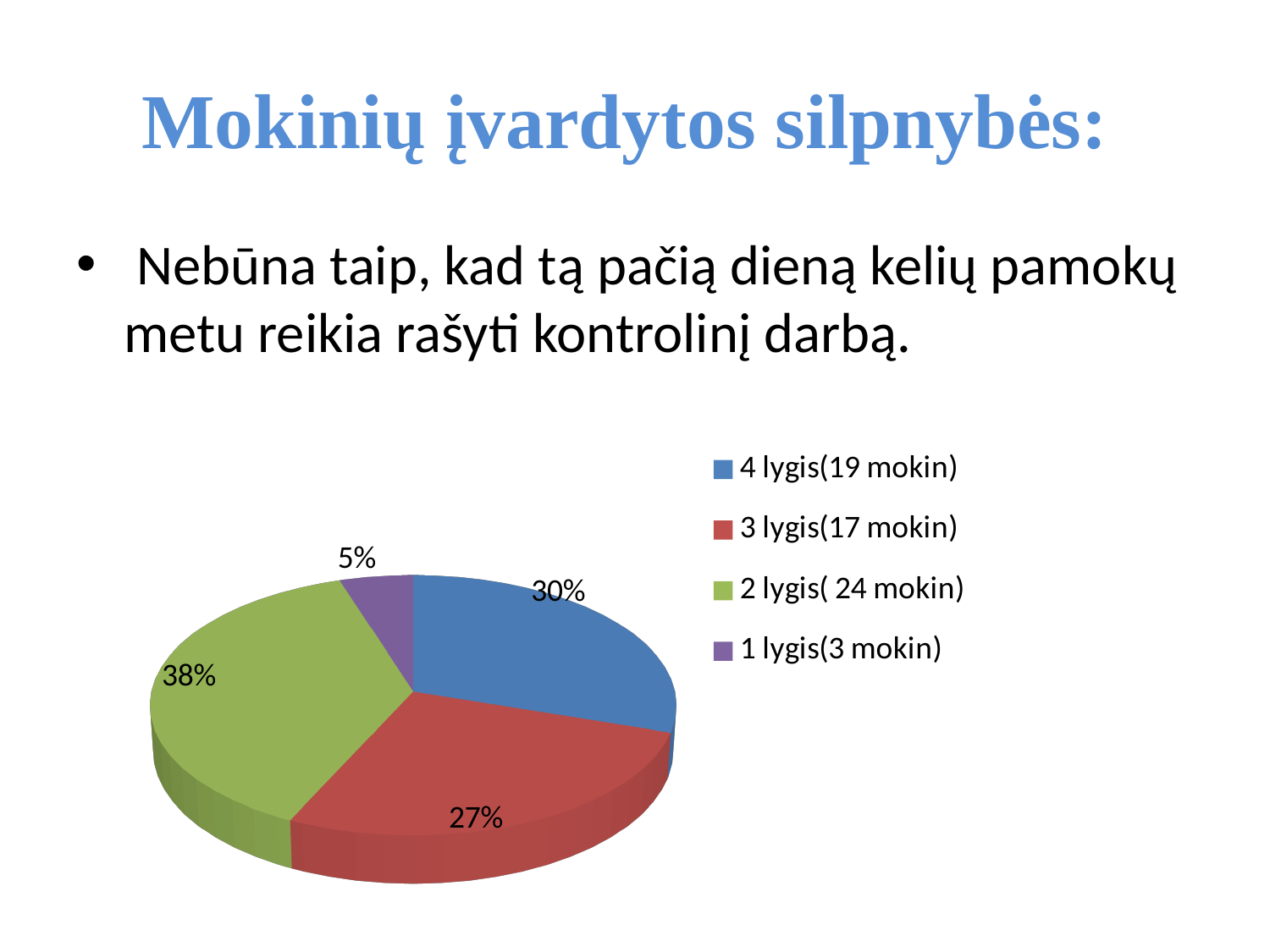
What percentage is shown for the slice labelled 4 lygis(19 mokin)? 30% Which slice of the pie chart is the smallest? 1 lygis(3 mokin) Which slice is larger: 4 lygis(19 mokin) or 3 lygis(17 mokin)? 4 lygis(19 mokin) What percentage is shown for the slice labelled 2 lygis( 24 mokin)? 38% What is the difference in percentage points between the 2 lygis( 24 mokin) slice and the 4 lygis(19 mokin) slice? 8 What kind of chart is shown on the slide? pie chart Which legend entry is shown in blue? 4 lygis(19 mokin) What colour is the slice for 2 lygis( 24 mokin)? green What percentage is shown for the slice labelled 1 lygis(3 mokin)? 5% What percentage is shown for the slice labelled 3 lygis(17 mokin)? 27% How many slices does the pie chart have? 4 Which slice of the pie chart is the largest? 2 lygis( 24 mokin)